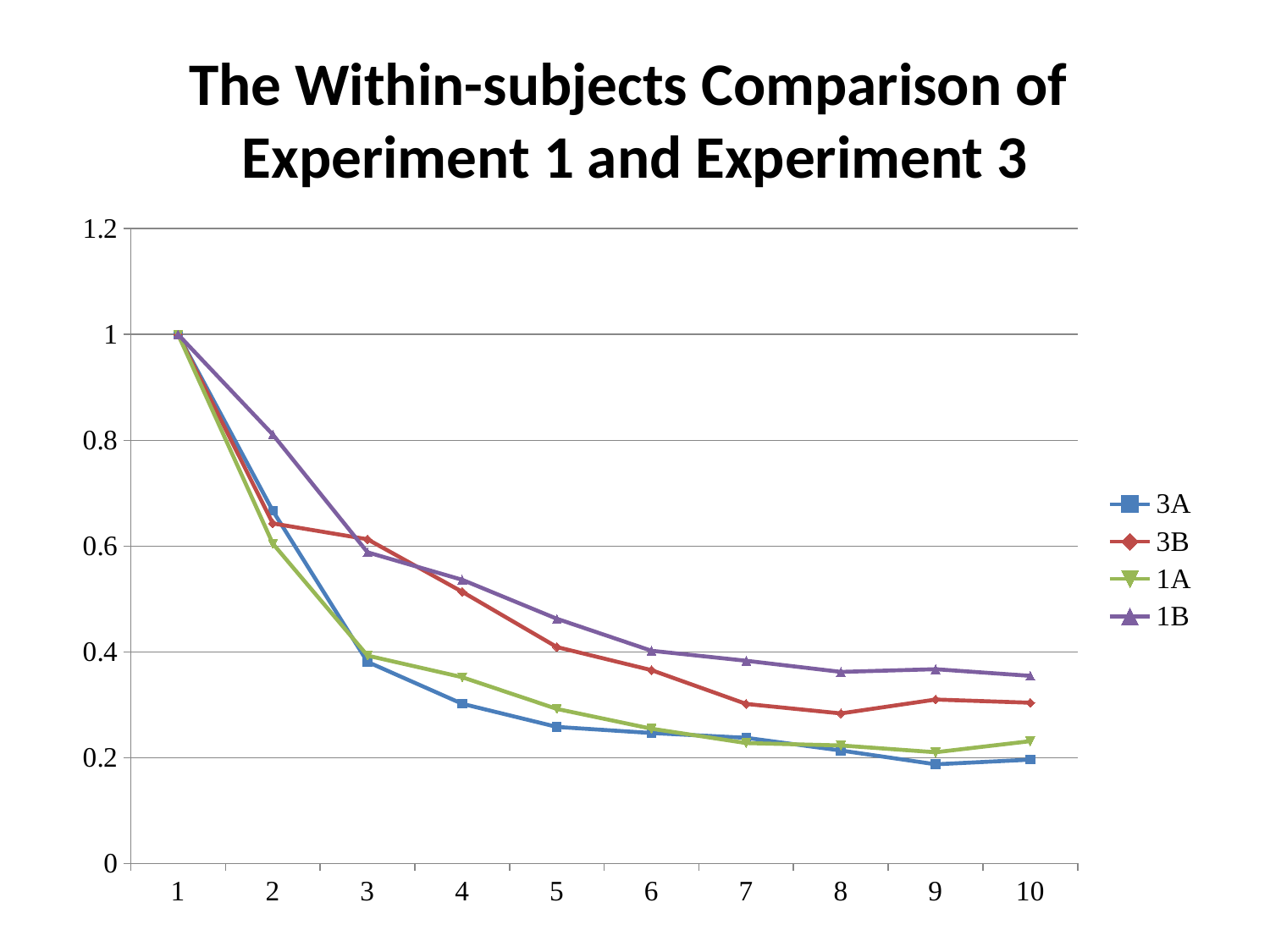
Is the value for series 3A at x = 3 greater or less than 0.4? less Which series has the lowest value at x = 10? 3A Do the values of series 3A rise or fall overall from x = 1 to x = 10? fall Is the value for series 3A at x = 9 greater or less than 0.2? less What kind of chart is shown on the slide? line chart Which series has the highest value at x = 10? 1B How many points are plotted along the x axis for each series? 10 Is the value for series 1B at x = 5 greater or less than 0.4? greater What is the title of the chart? The Within-subjects Comparison of Experiment 1 and Experiment 3 How many series does the legend list? 4 What is the value of series 3A at x = 1? 1 At x = 5, which series has the larger value, 1B or 3A? 1B